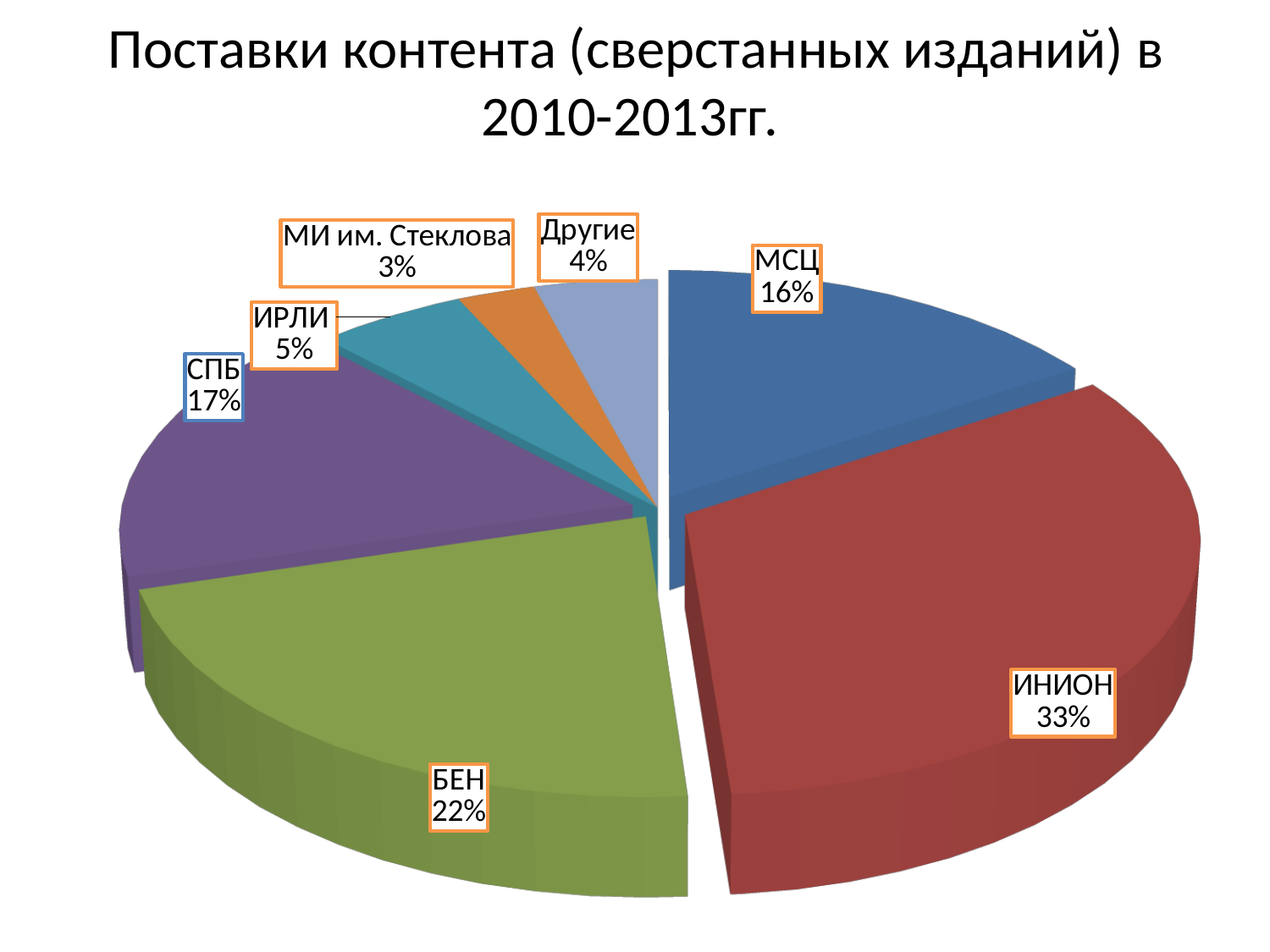
What kind of chart is shown on the slide? Pie chart What is the value shown for МИ им. Стеклова? 3% How many slices does the pie chart have? 7 Which category has the largest slice of the pie? ИНИОН What is the difference in percentage points between ИНИОН and БЕН? 11 What is the title of the chart on the slide? Поставки контента (сверстанных изданий) в 2010-2013гг. What is the value shown for БЕН? 22% What is the value shown for МСЦ? 16% What share of the pie does ИНИОН hold? 33% Which category has the smallest slice of the pie? МИ им. Стеклова Which is larger, the share for ИРЛИ or the share for Другие? ИРЛИ What is the value shown for СПБ? 17%